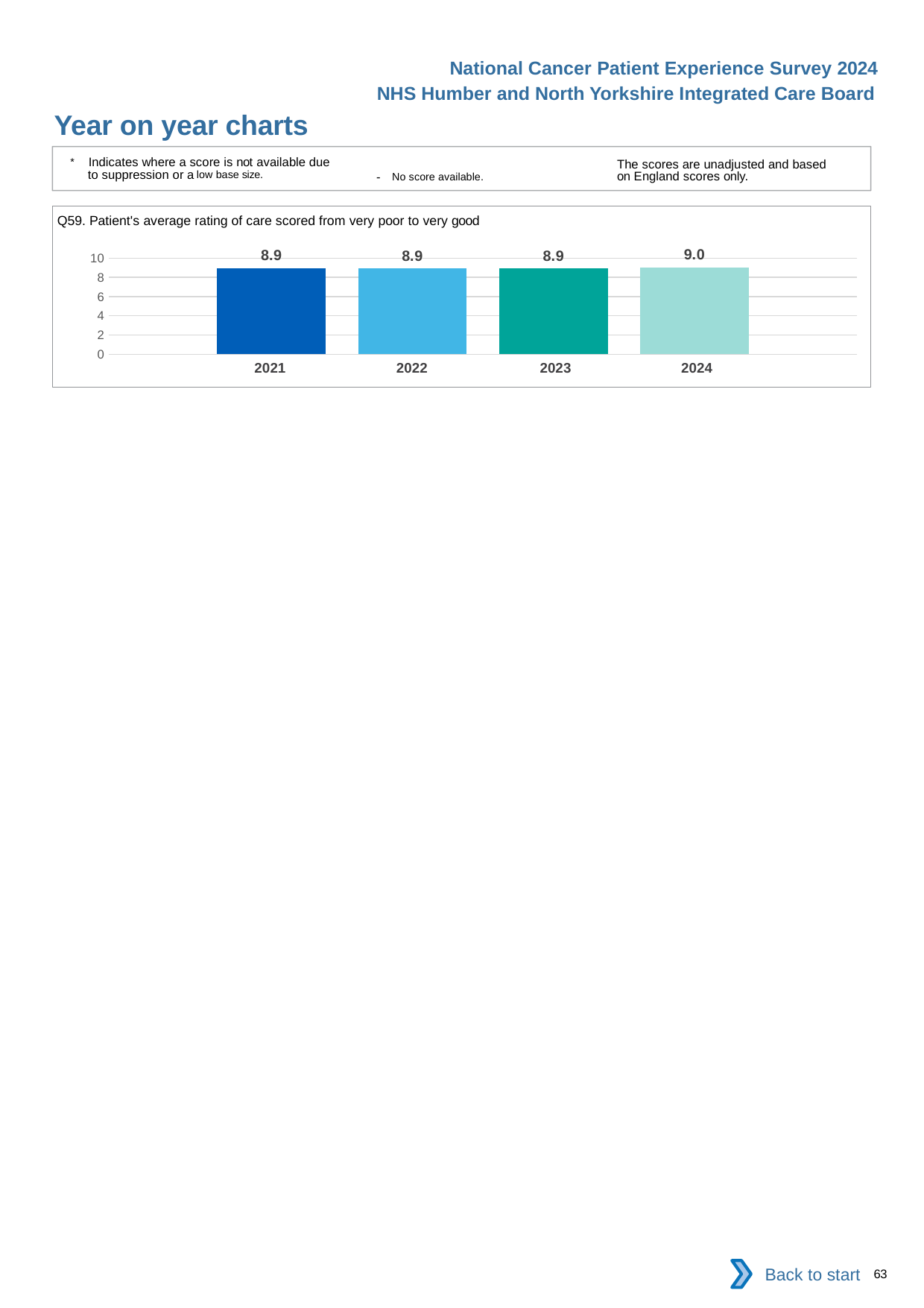
Which year has the highest value? 2024 What is the maximum value shown on the y axis? 10 What is the value for 2021? 8.9 What is the difference between the values for 2024 and 2022? 0.1 What is the value for 2024? 9.0 How many years are shown on the chart? 4 Is the value for 2022 greater or less than 8? greater What is the title of the chart? Q59. Patient's average rating of care scored from very poor to very good What is the value for 2023? 8.9 Do the values rise or fall from 2023 to 2024? rise What kind of chart is shown? bar chart